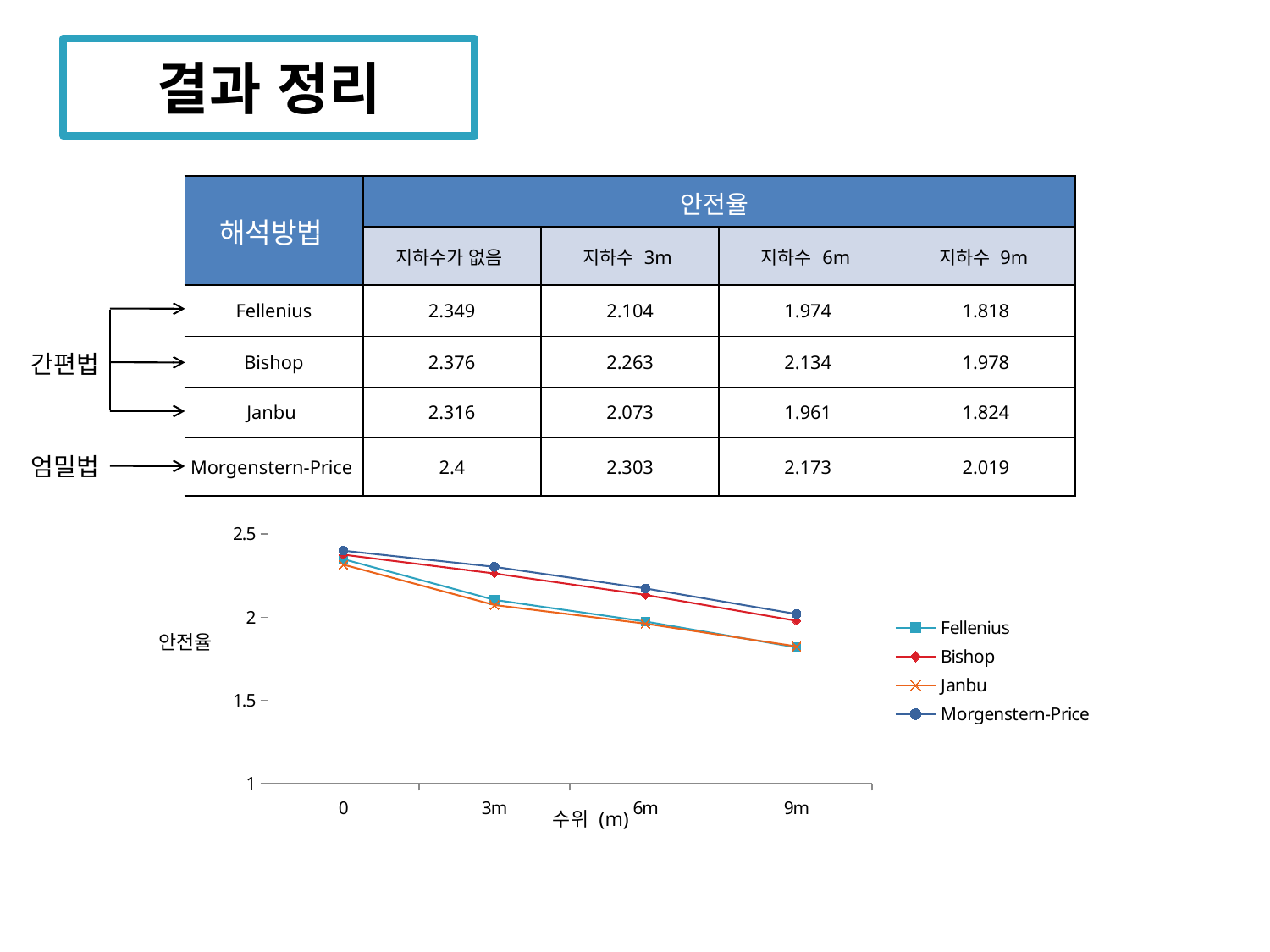
At 3m, which is larger, the Bishop value or the Janbu value? Bishop How many series does the chart legend list? 4 What kind of chart is shown on the slide? line chart What is the label on the y axis of the chart? 안전율 Do the safety factor values rise or fall as the water level increases from 0 to 9m? fall Which method has the highest safety factor at 9m? Morgenstern-Price Is the Fellenius value at 9m greater or less than 2? less Which method has the lowest safety factor at 0 (no groundwater)? Janbu What is the safety factor for Bishop at 6m? 2.134 How many water-level points are plotted along the x axis of the chart? 4 What is the safety factor for Morgenstern-Price at 0 (no groundwater)? 2.4 What is the difference between the Fellenius safety factor at 0 and at 9m? 0.531